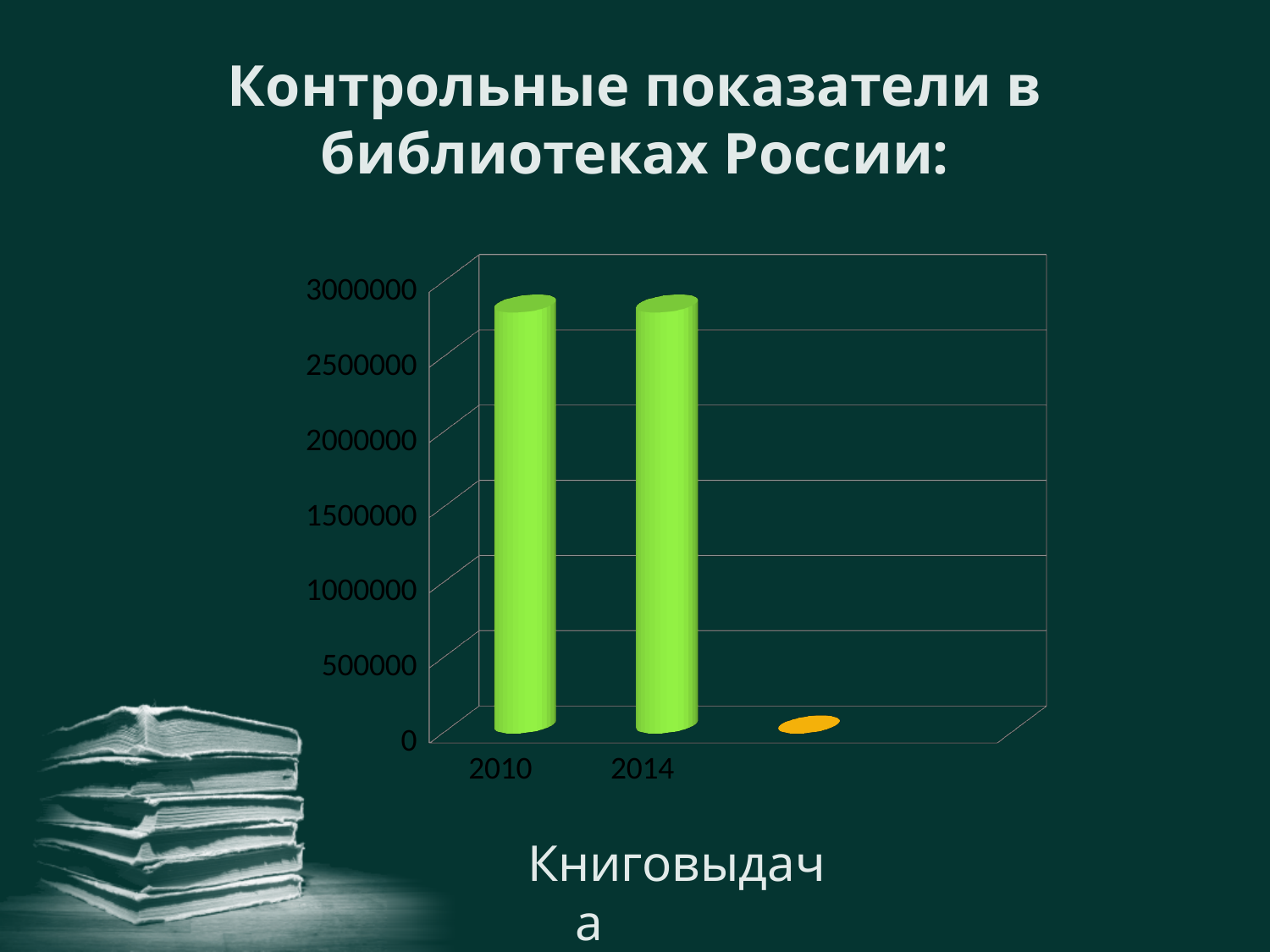
What kind of chart is shown on the slide? bar chart Is the value for 2014 greater or less than 2000000? greater What is the highest value shown on the vertical axis of the chart? 3000000 Is the value for 2010 greater or less than 2500000? greater Is the value for 2014 greater or less than 3000000? less Which two years are shown as categories on the x axis? 2010 and 2014 What is the title of the slide containing the chart? Контрольные показатели в библиотеках России: How many years are labelled on the x axis of the chart? 2